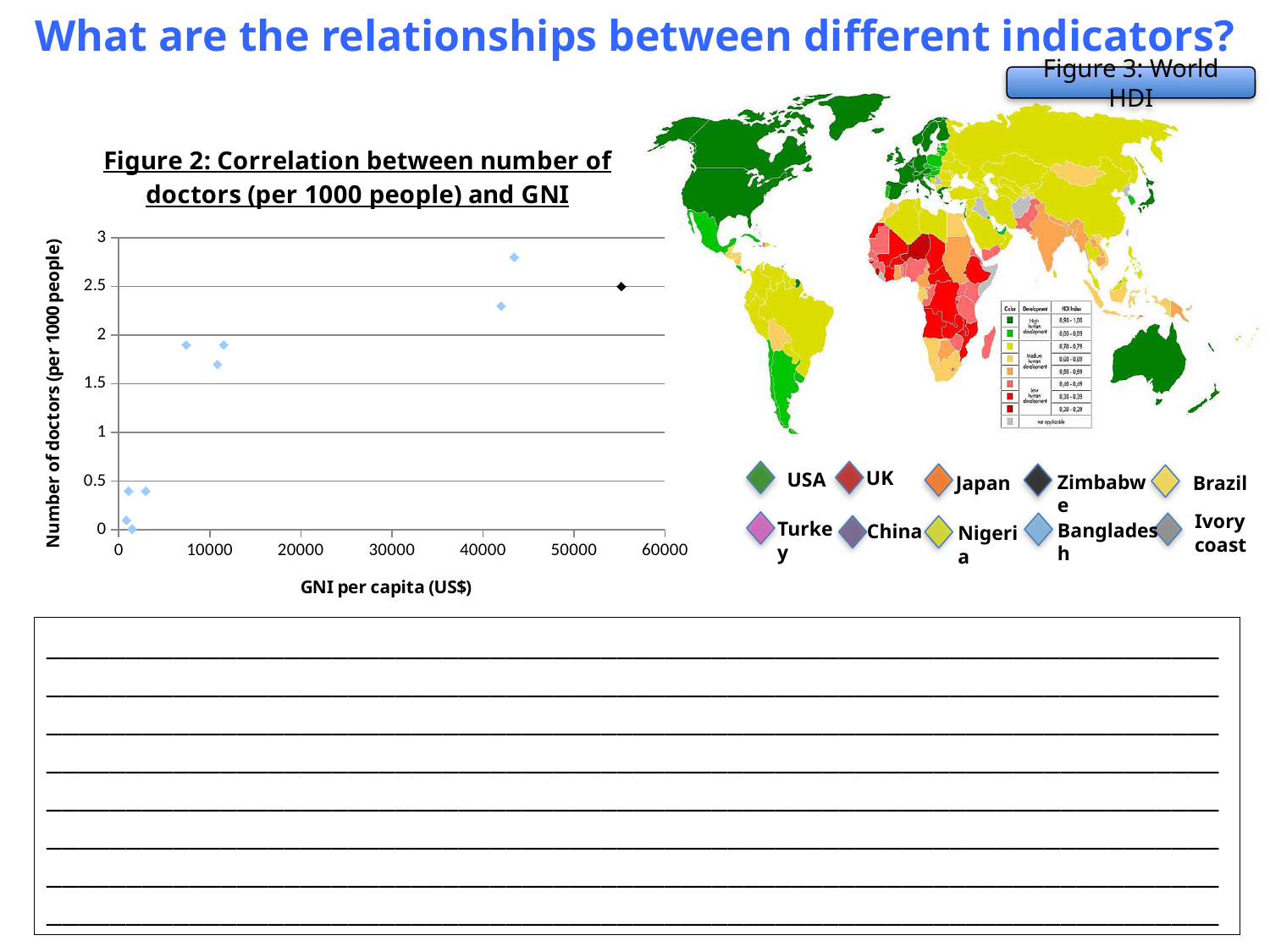
In Figure 2, is the number of doctors for the points around 10000 GNI per capita greater or less than 1.5? greater In Figure 2, are the points with GNI per capita below 5000 greater or less than 0.5 doctors per 1000 people? less In Figure 2, is the highest plotted number of doctors per 1000 people greater or less than 2.5? greater What is the highest value shown on the x axis of Figure 2? 60000 What is the label of the y axis in Figure 2? Number of doctors (per 1000 people) What kind of chart is Figure 2? scatter chart In Figure 2, do the number of doctors per 1000 people generally rise or fall as GNI per capita increases? rise